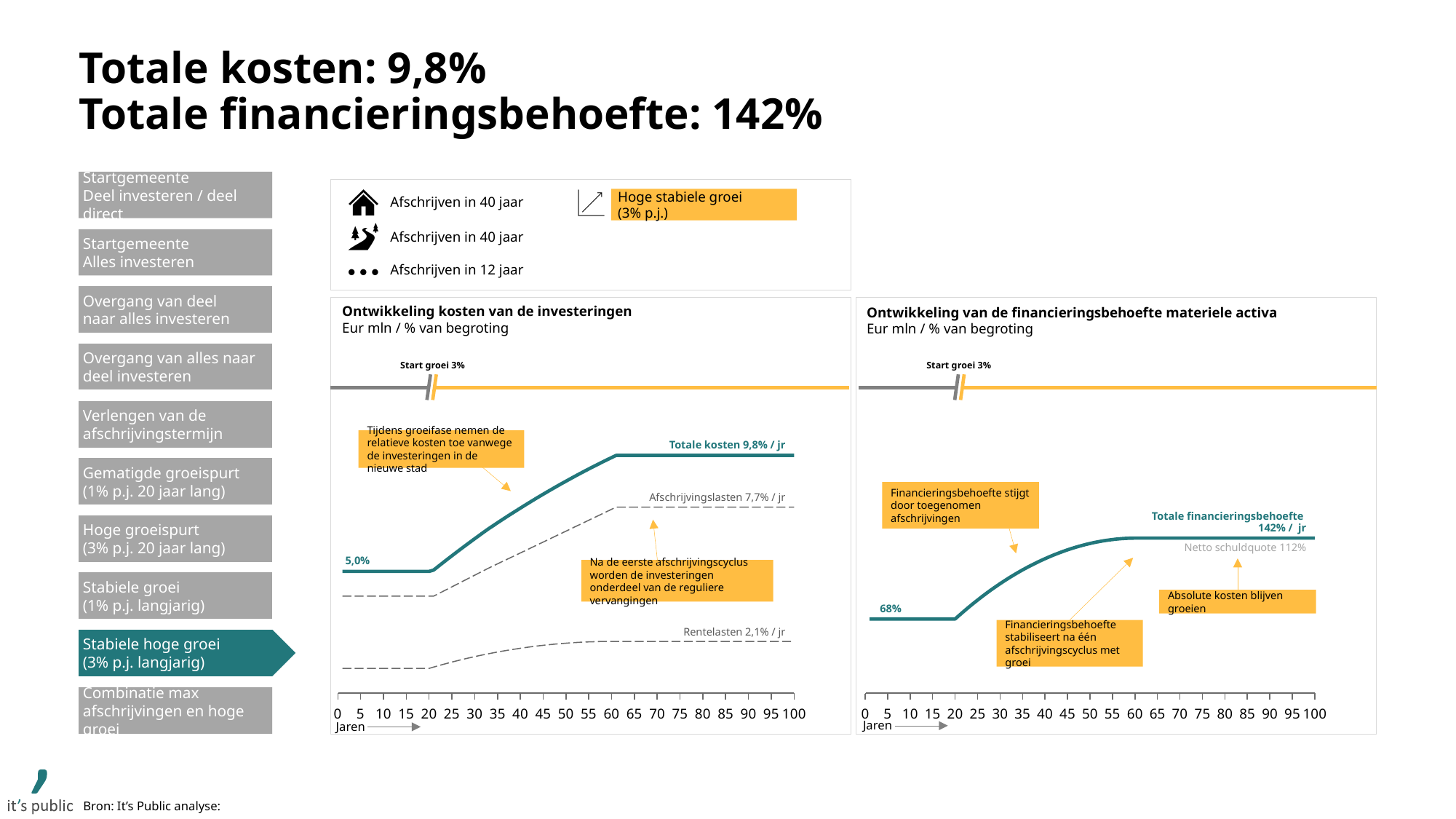
What kind of chart is 'Ontwikkeling kosten van de investeringen'? Line chart In the chart 'Ontwikkeling van de financieringsbehoefte materiele activa', what is the highest value shown on the x axis (Jaren)? 100 In the chart 'Ontwikkeling van de financieringsbehoefte materiele activa', what is the starting value of the line? 68% In the chart 'Ontwikkeling van de financieringsbehoefte materiele activa', what value does 'Totale financieringsbehoefte' reach? 142% / jr In the chart 'Ontwikkeling kosten van de investeringen', which line has the lowest value at the end? Rentelasten In the chart 'Ontwikkeling kosten van de investeringen', what value is labelled for 'Afschrijvingslasten'? 7,7% / jr In the chart 'Ontwikkeling kosten van de investeringen', does the 'Totale kosten' line rise or fall between year 20 and year 60? Rise In the chart 'Ontwikkeling van de financieringsbehoefte materiele activa', what value is labelled for 'Netto schuldquote'? 112% In the chart 'Ontwikkeling kosten van de investeringen', what is the starting value of the 'Totale kosten' line? 5,0% In the chart 'Ontwikkeling kosten van de investeringen', what value does the 'Totale kosten' line reach at the end? 9,8% / jr In the chart 'Ontwikkeling kosten van de investeringen', what is the difference between the 'Totale kosten' end value and the 'Afschrijvingslasten' value? 2,1% In the chart 'Ontwikkeling kosten van de investeringen', what value is labelled for 'Rentelasten'? 2,1% / jr